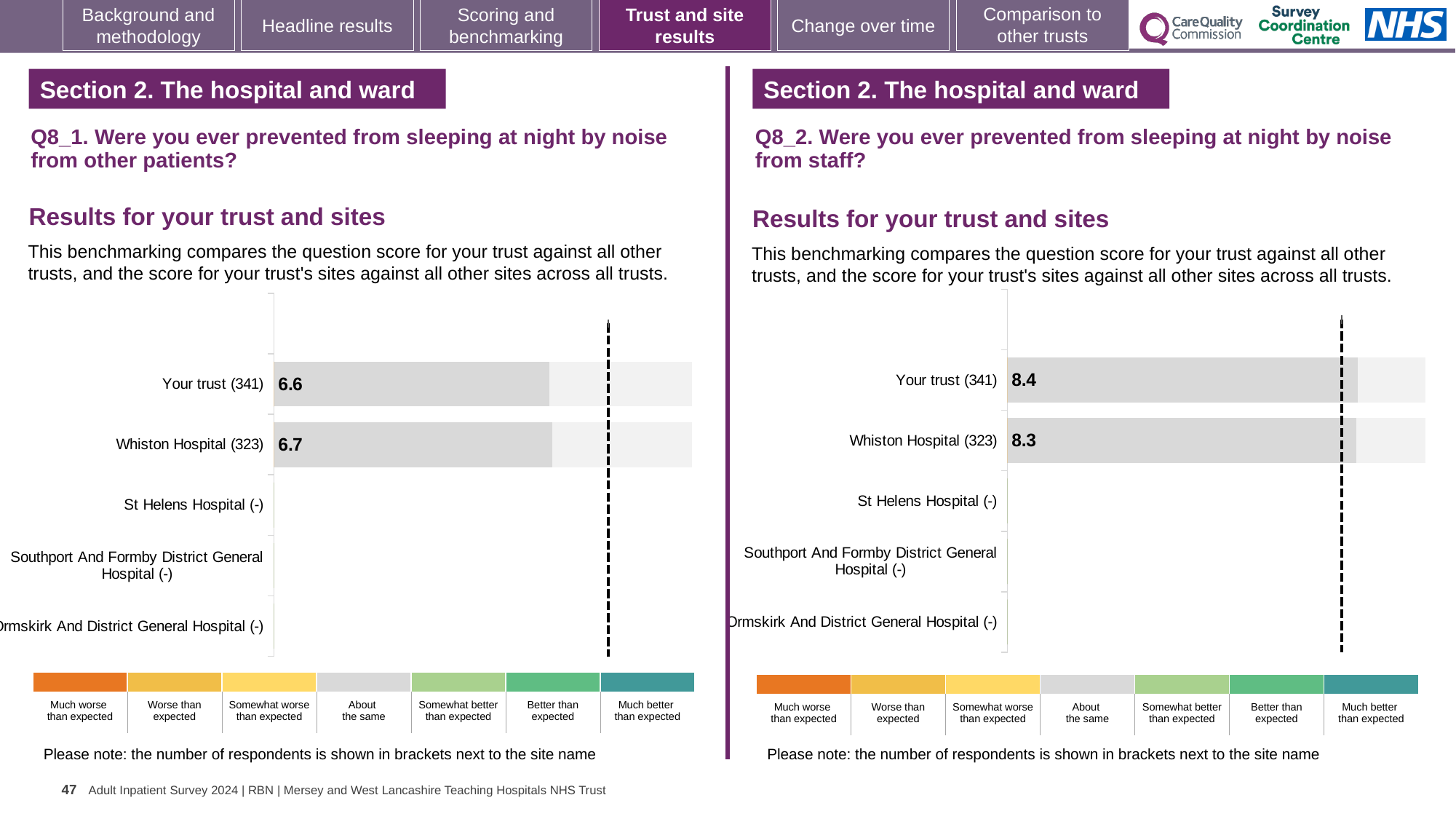
In the Q8_2 chart (noise from staff), how many respondents are shown in brackets for Whiston Hospital? 323 What type of chart is used in the Q8_2 chart (noise from staff)? Bar chart In the Q8_1 chart (noise from other patients), what is the score for Your trust? 6.6 In the Q8_2 chart (noise from staff), what is the difference between the Your trust score and the Whiston Hospital score? 0.1 How many site/trust categories are listed on the vertical axis of the Q8_1 chart (noise from other patients)? 5 How many benchmark categories does the colour legend below the Q8_2 chart (noise from staff) list? 7 In the Q8_2 chart (noise from staff), what is the score for Whiston Hospital? 8.3 In the Q8_1 chart (noise from other patients), how many respondents are shown in brackets for Your trust? 341 In the Q8_1 chart (noise from other patients), what is the score for Whiston Hospital? 6.7 In the Q8_1 chart (noise from other patients), what is the difference between the Whiston Hospital score and the Your trust score? 0.1 In the Q8_2 chart (noise from staff), what is the score for Your trust? 8.4 In the Q8_1 chart (noise from other patients), which category has the higher score, Your trust or Whiston Hospital? Whiston Hospital